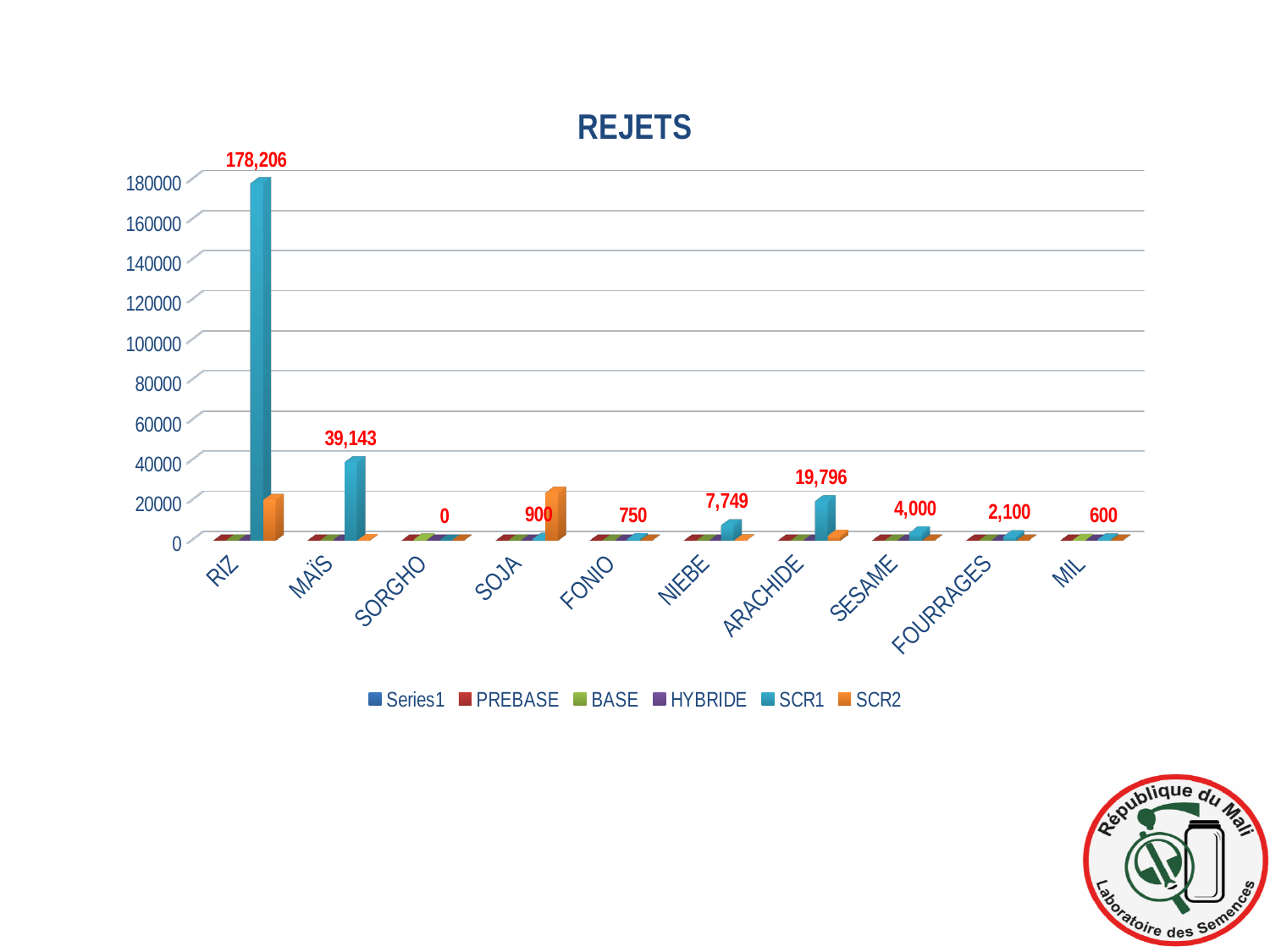
What value is labelled for SESAME? 4,000 Which category has the highest labelled value? RIZ Which has the larger labelled value, FOURRAGES or MIL? FOURRAGES How many categories are shown on the x axis? 10 What is the difference between the labelled values for RIZ and MAÏS? 139,063 Is the tallest bar for RIZ greater or less than 160000? greater What value is labelled for ARACHIDE? 19,796 What value is labelled for RIZ? 178,206 What is the difference between the labelled values for ARACHIDE and NIEBE? 12,047 Which category has the lowest labelled value? SORGHO How many series does the legend list? 6 What value is labelled for FONIO? 750